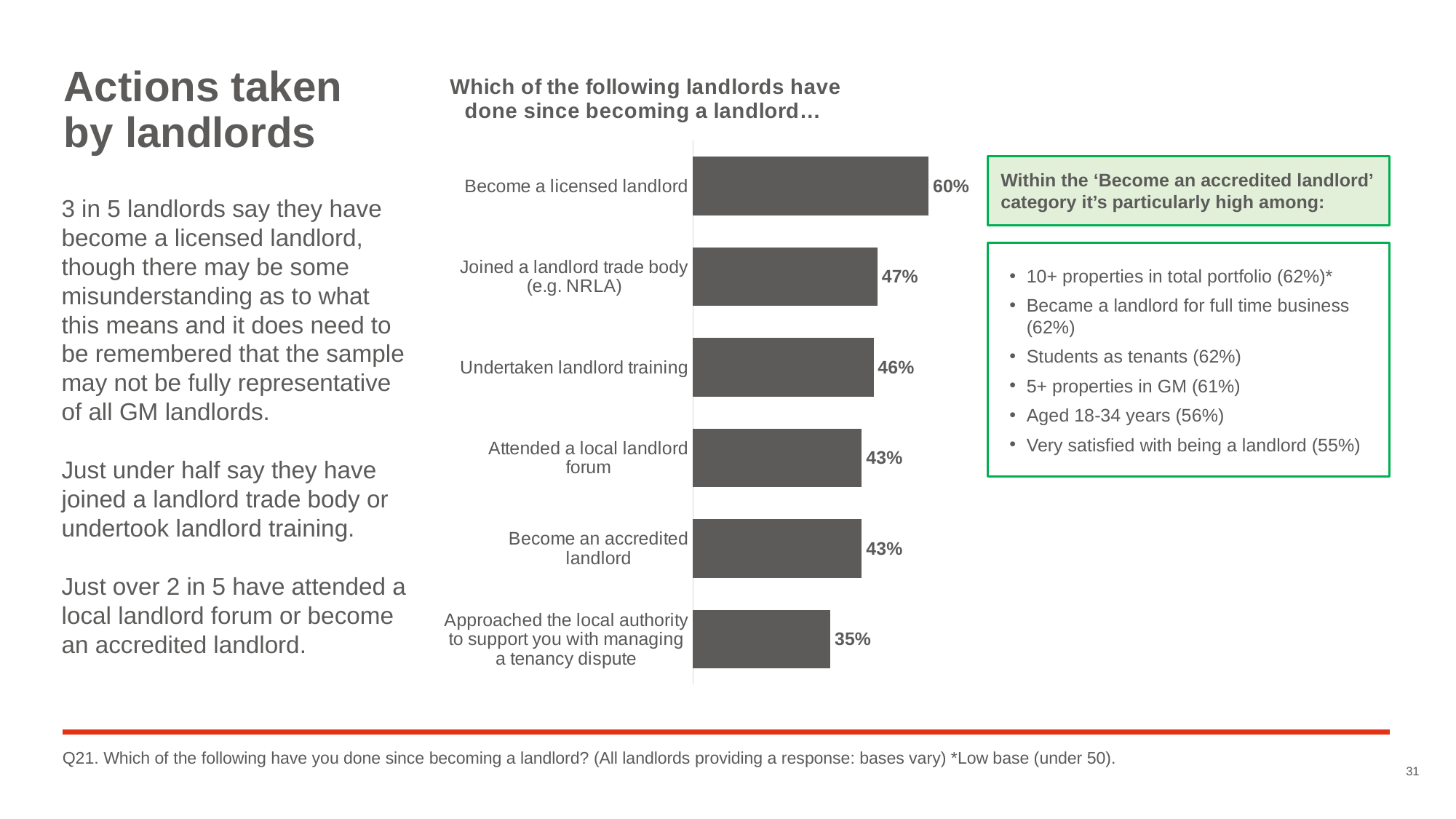
Which is larger: the percentage for 'Undertaken landlord training' or for 'Attended a local landlord forum'? Undertaken landlord training What percentage of landlords have become an accredited landlord? 43% What type of chart is used on this slide? Bar chart What is the difference in percentage points between 'Become a licensed landlord' and 'Joined a landlord trade body (e.g. NRLA)'? 13 What percentage of landlords have undertaken landlord training? 46% What is the title of the chart? Which of the following landlords have done since becoming a landlord… Which action has the highest percentage of landlords? Become a licensed landlord What percentage of landlords say they have become a licensed landlord? 60% What percentage of landlords have approached the local authority to support them with managing a tenancy dispute? 35% How many actions (categories) are shown in the chart? 6 Which action has the lowest percentage of landlords? Approached the local authority to support you with managing a tenancy dispute What percentage of landlords have joined a landlord trade body (e.g. NRLA)? 47%